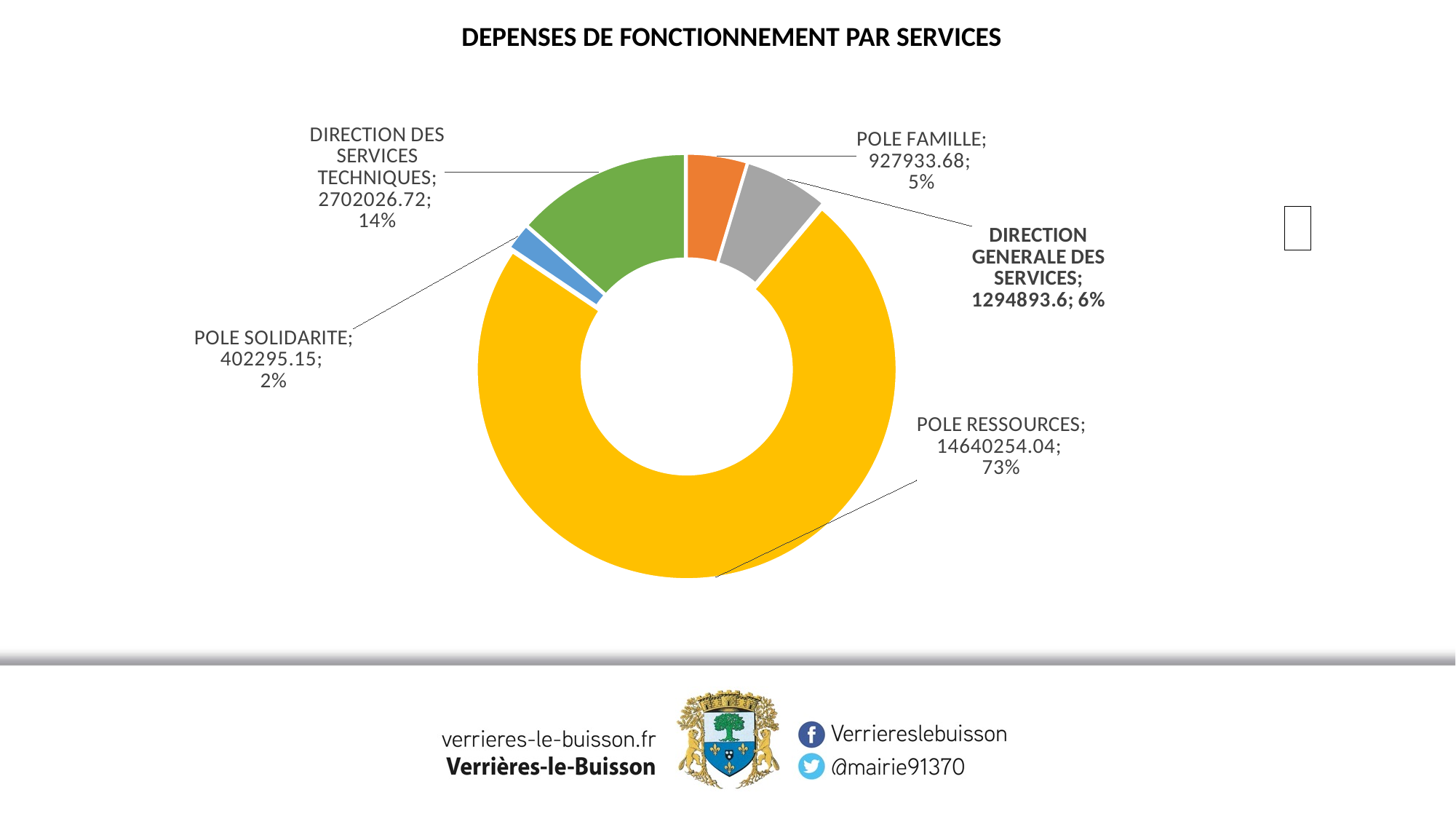
Which service has the smallest share of the chart? POLE SOLIDARITE What percentage share does POLE FAMILLE represent? 5% What is the difference between the values for DIRECTION DES SERVICES TECHNIQUES and POLE FAMILLE? 1774093.04 What is the title of the chart? DEPENSES DE FONCTIONNEMENT PAR SERVICES What is the value for DIRECTION DES SERVICES TECHNIQUES? 2702026.72 What is the value for POLE SOLIDARITE? 402295.15 Which is larger, the value for DIRECTION GENERALE DES SERVICES or the value for POLE FAMILLE? DIRECTION GENERALE DES SERVICES What is the value for POLE RESSOURCES? 14640254.04 Which service has the largest share of the chart? POLE RESSOURCES How many slices does the chart have? 5 What percentage share does DIRECTION GENERALE DES SERVICES represent? 6% What type of chart is shown on the slide? Doughnut (pie) chart